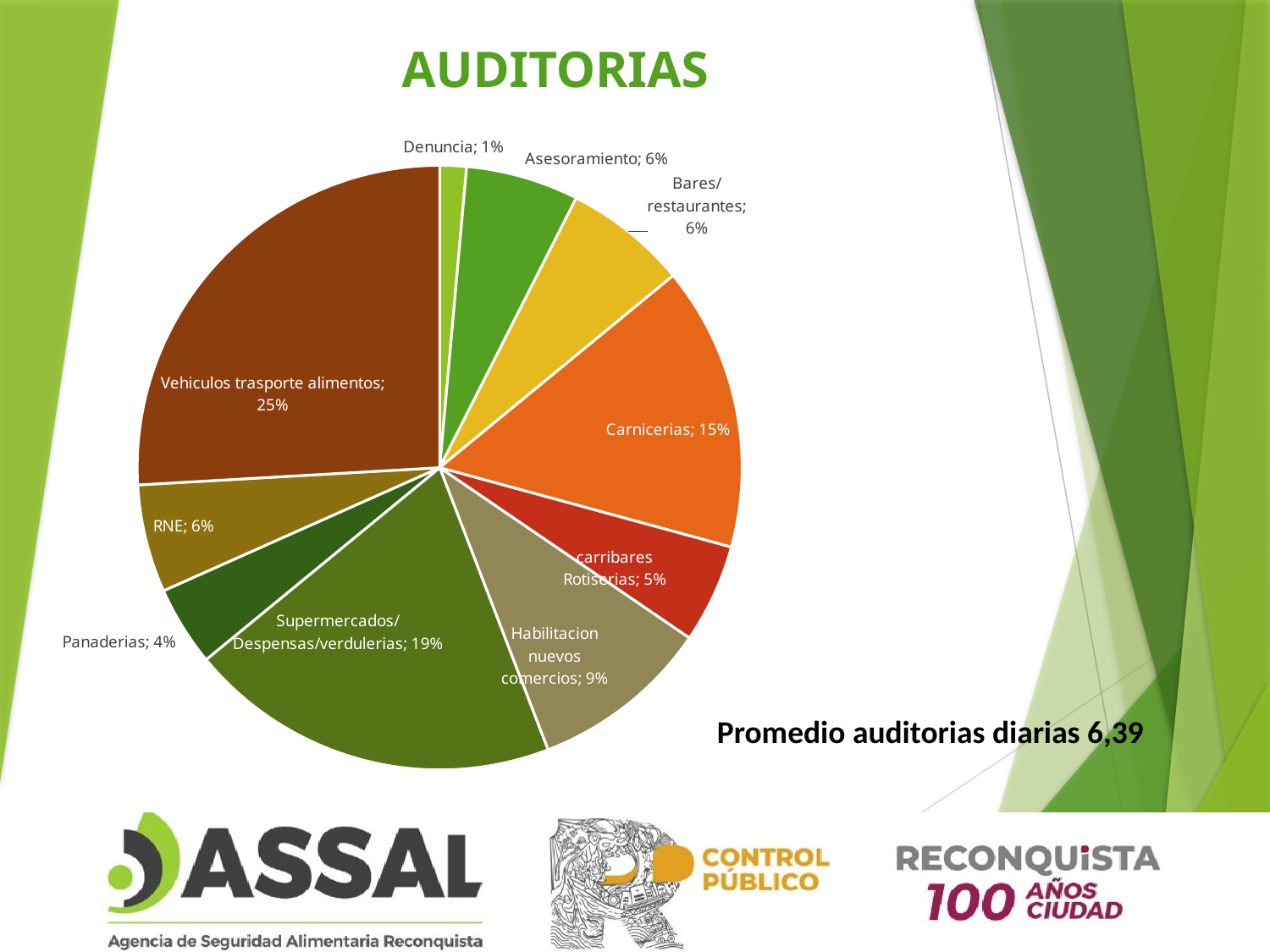
What percentage of the pie chart is Habilitacion nuevos comercios? 9% Which category has the smallest share of the pie chart? Denuncia How many slices does the pie chart have? 10 What percentage of the pie chart is Carnicerias? 15% Which category has the largest share of the pie chart? Vehiculos trasporte alimentos What is the title of the chart on the slide? AUDITORIAS What is the difference in percentage points between Vehiculos trasporte alimentos and Supermercados/Despensas/verdulerias? 6 What percentage of the pie chart is Vehiculos trasporte alimentos? 25% What type of chart is shown on the slide? Pie chart What percentage of the pie chart is Supermercados/Despensas/verdulerias? 19% What percentage of the pie chart is Panaderias? 4% Which is larger, the share for Carnicerias or the share for Habilitacion nuevos comercios? Carnicerias